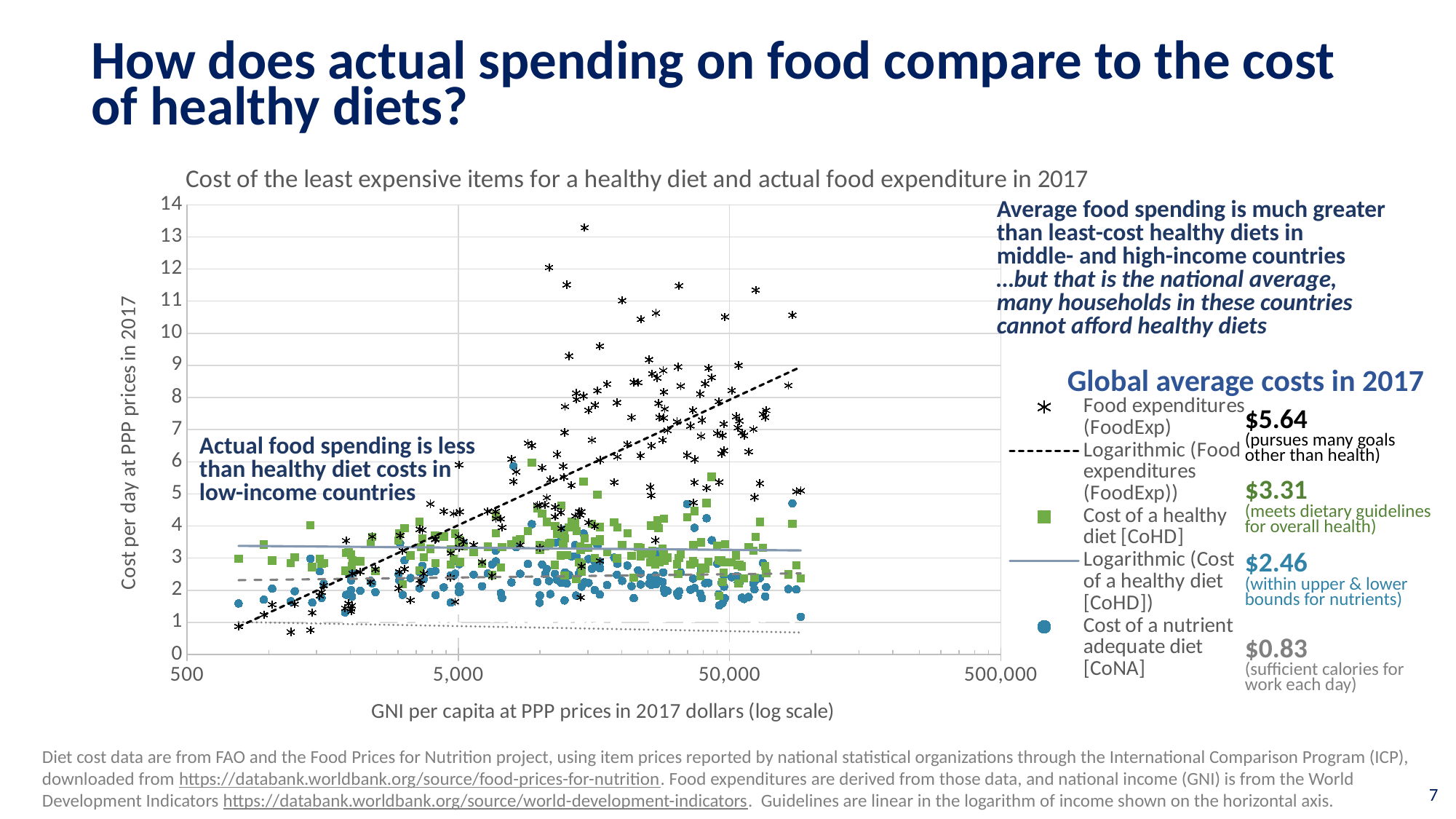
Does the logarithmic trend line for Food expenditures rise or fall as GNI per capita increases along the x axis? rise What is the title of the chart? Cost of the least expensive items for a healthy diet and actual food expenditure in 2017 How many entries does the chart legend list? 5 Which of the global average costs listed for 2017 is the highest? Food expenditures (FoodExp), $5.64 According to the 'Global average costs in 2017' panel, what is the global average Cost of a nutrient adequate diet [CoNA]? $2.46 Which is larger: the global average Cost of a healthy diet [CoHD] or the global average Cost of a nutrient adequate diet [CoNA]? Cost of a healthy diet [CoHD] What is the label of the horizontal axis of the chart? GNI per capita at PPP prices in 2017 dollars (log scale) According to the 'Global average costs in 2017' panel, what is the global average for Food expenditures (FoodExp)? $5.64 Which of the global average costs listed for 2017 is the lowest? $0.83 (sufficient calories for work each day) What is the difference between the global average Food expenditures ($5.64) and the global average Cost of a healthy diet ($3.31)? $2.33 According to the 'Global average costs in 2017' panel, what is the global average Cost of a healthy diet [CoHD]? $3.31 What kind of chart is shown on the slide? scatter chart